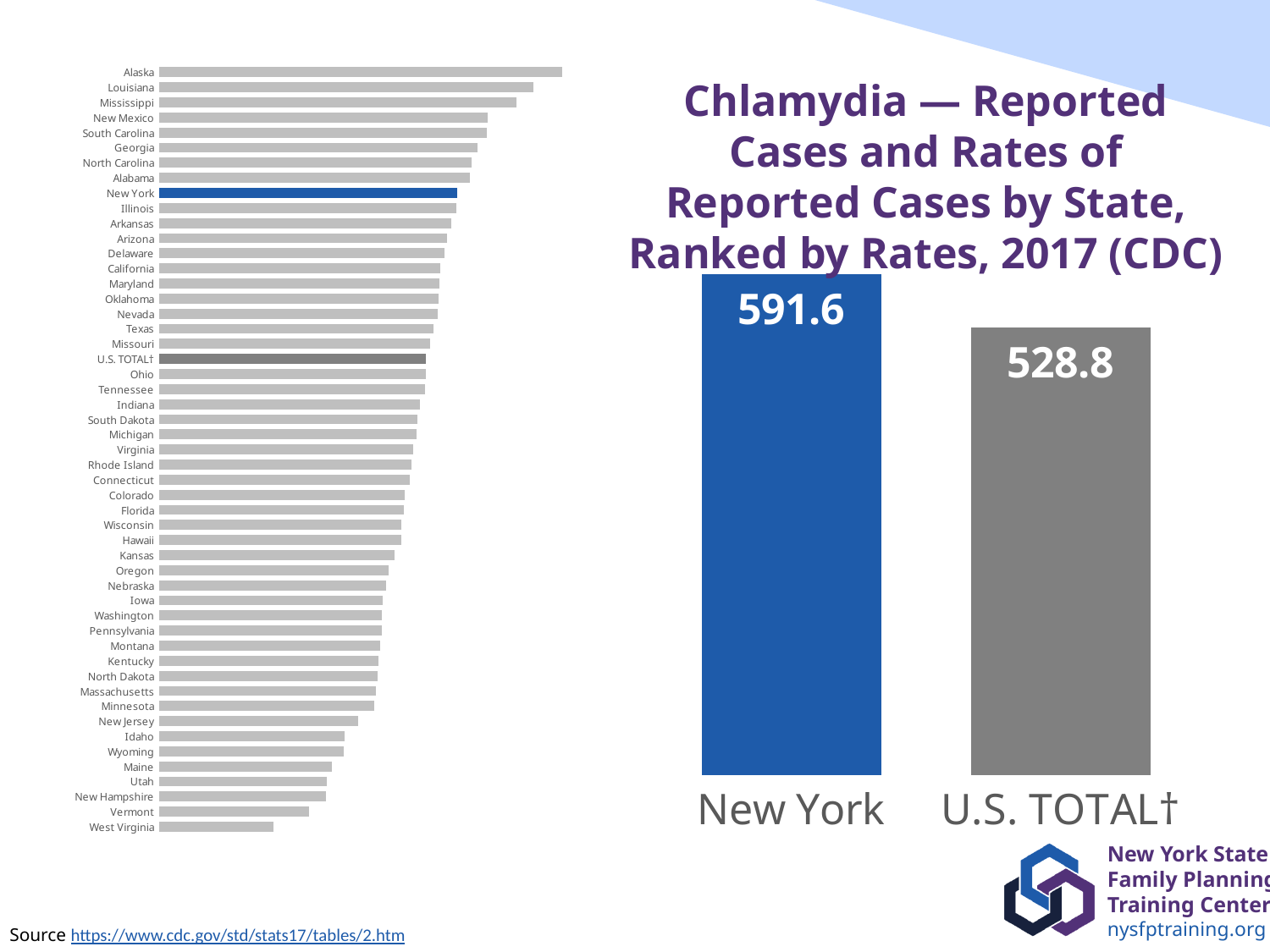
On the left-hand chart, which bar is highlighted in blue? New York On the right-hand chart, which is larger, New York or U.S. TOTAL†? New York What kind of chart is the left-hand chart? Bar chart On the right-hand chart, what is the difference between the New York value and the U.S. TOTAL† value? 62.8 On the right-hand chart, how many bars are plotted? 2 On the left-hand chart of states ranked by rate, which category has the longest bar? Alaska What kind of chart is the right-hand chart? Bar chart On the left-hand chart, which has the longer bar, New Jersey or Minnesota? Minnesota On the left-hand chart of states ranked by rate, which category has the shortest bar? West Virginia On the left-hand chart, which has the longer bar, Louisiana or Mississippi? Louisiana On the right-hand chart, what is the value shown for New York? 591.6 On the right-hand chart, what is the value shown for U.S. TOTAL†? 528.8